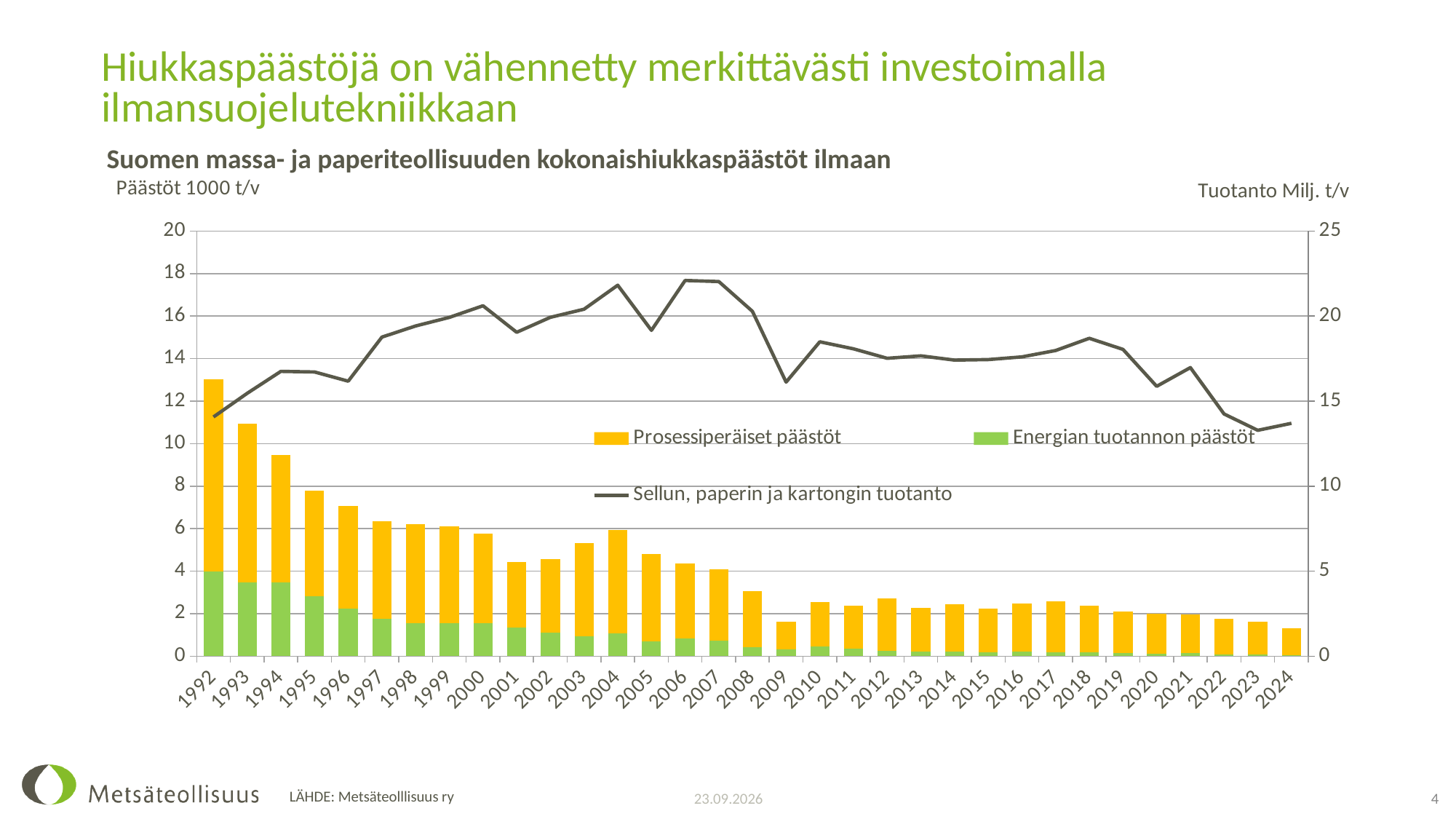
Is the total emissions bar for 1992 greater or less than 12 (1000 t/v)? greater Is the production line value (Sellun, paperin ja kartongin tuotanto) for 2006 greater or less than 20 Milj. t/v? greater Is the production line value (Sellun, paperin ja kartongin tuotanto) for 2023 greater or less than 15 Milj. t/v? less Which year has the lowest total particulate emissions (shortest stacked bar)? 2024 Do the total particulate emissions generally rise or fall from 1992 to 2024? fall What is the label of the right-hand vertical axis? Tuotanto Milj. t/v What kind of chart is shown on the slide? A stacked bar chart combined with a line chart Which year has the larger total emissions bar, 2009 or 2010? 2010 How many series does the chart's legend list? 3 Which year has the highest total particulate emissions (tallest stacked bar)? 1992 How many years are shown on the x axis of the chart? 33